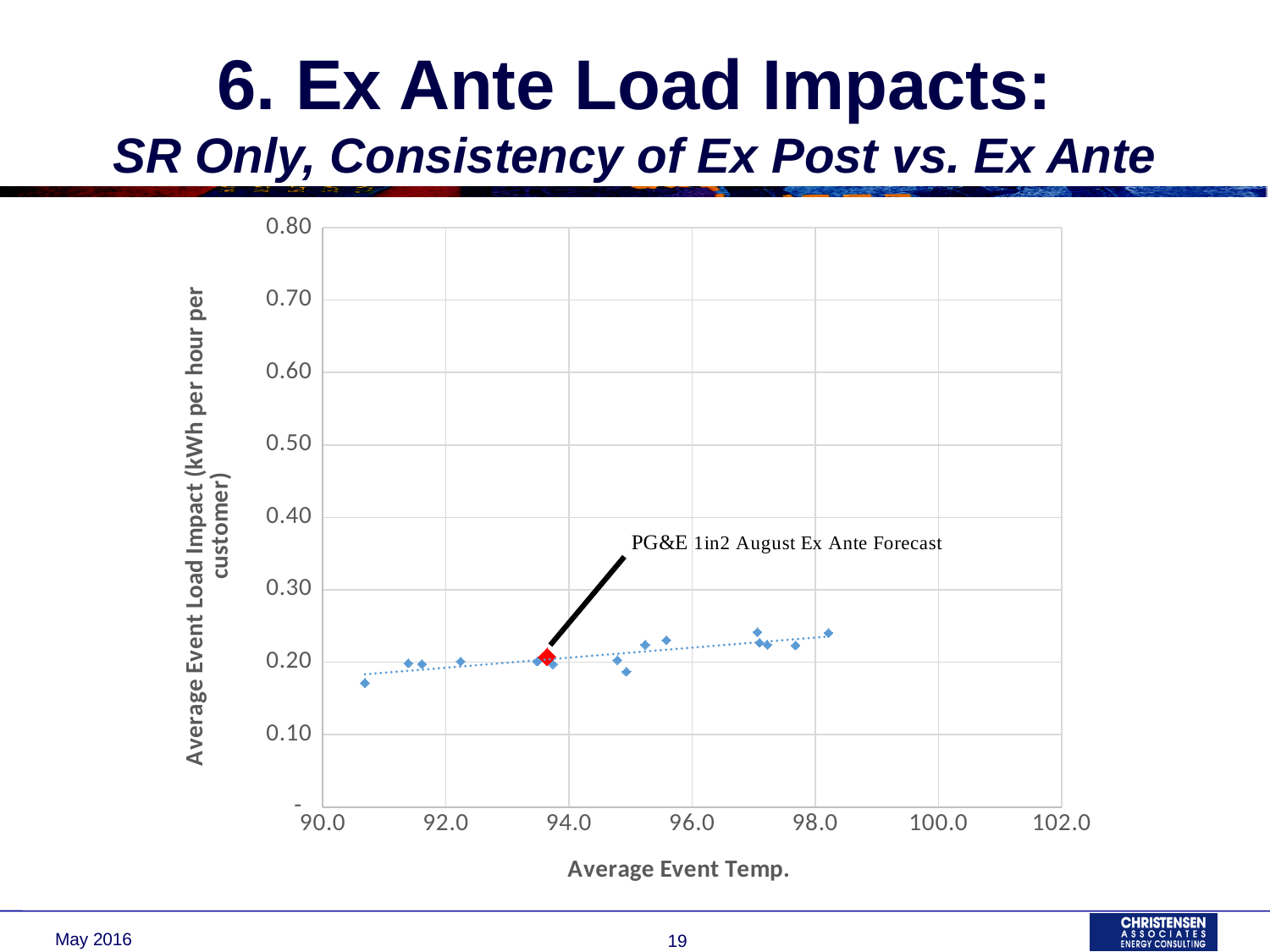
Is the highest plotted load impact value greater or less than 0.30? less Is the load impact value for the leftmost point (near 90.7 on the x axis) greater or less than 0.20? less What does the red diamond marker on the chart represent, according to the annotation? PG&E 1in2 August Ex Ante Forecast Is the load impact value for the rightmost point (near 98.2 on the x axis) greater or less than 0.20? greater What is the highest value shown on the y axis of the chart? 0.80 Which has the larger load impact: the leftmost point near 90.7 or the rightmost point near 98.2? The rightmost point near 98.2 What kind of chart is shown on the slide? Scatter chart Do the plotted load impact values generally rise or fall as average event temperature increases along the x axis? Rise What is the title of the y axis of the chart? Average Event Load Impact (kWh per hour per customer) What is the title of the x axis of the chart? Average Event Temp.